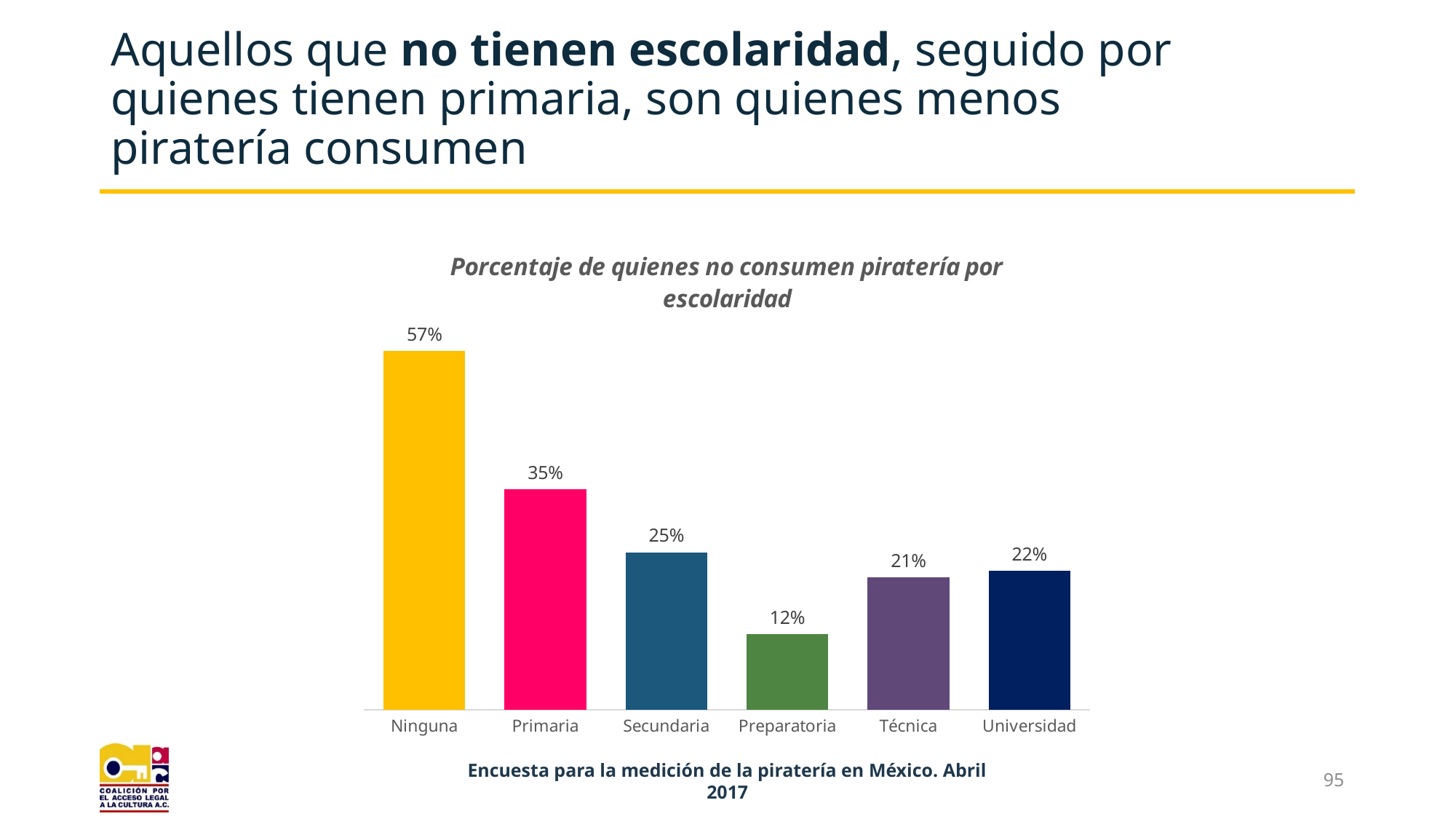
What is the value for Preparatoria? 12% What is the difference between the values for Ninguna and Primaria? 22% Which category has the highest value? Ninguna What is the difference between the values for Secundaria and Técnica? 4% What is the value for Ninguna? 57% What is the value for Primaria? 35% How many categories are shown on the x axis? 6 What kind of chart is shown on the slide? Bar chart What is the value for Universidad? 22% Which is larger, the value for Secundaria or the value for Universidad? Secundaria What is the title of the chart? Porcentaje de quienes no consumen piratería por escolaridad Which category has the lowest value? Preparatoria